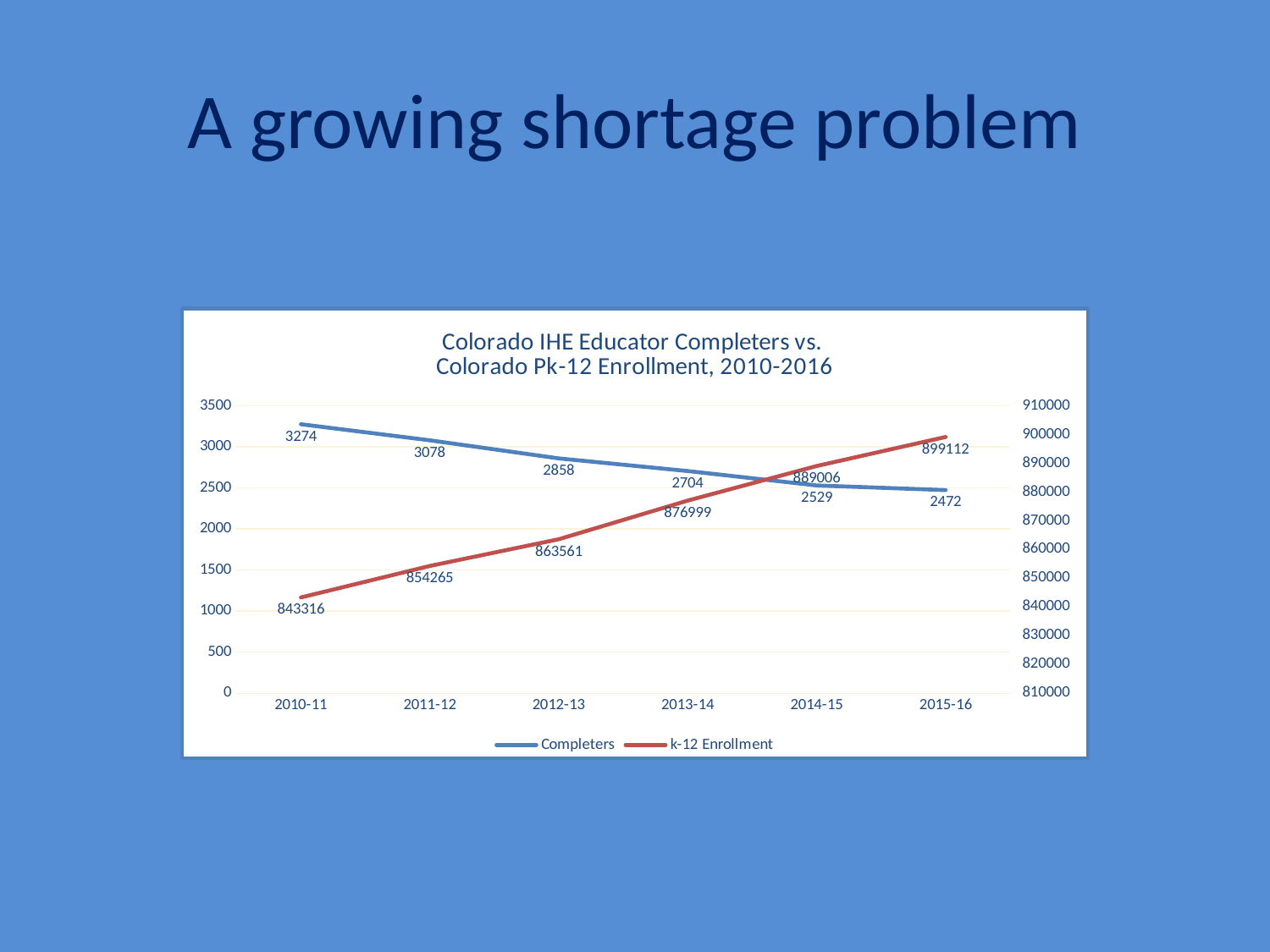
What is the k-12 Enrollment value for 2015-16? 899112 How many years are shown on the x axis? 6 What is the difference in k-12 Enrollment between 2011-12 and 2010-11? 10949 What is the difference in Completers between 2010-11 and 2015-16? 802 Do the Completers values rise or fall from 2010-11 to 2015-16? fall How many series does the legend list? 2 What is the number of Completers for 2013-14? 2704 What is the number of Completers for 2010-11? 3274 What is the k-12 Enrollment value for 2012-13? 863561 Which year has more Completers, 2011-12 or 2014-15? 2011-12 In which year are Completers lowest? 2015-16 In which year is k-12 Enrollment highest? 2015-16